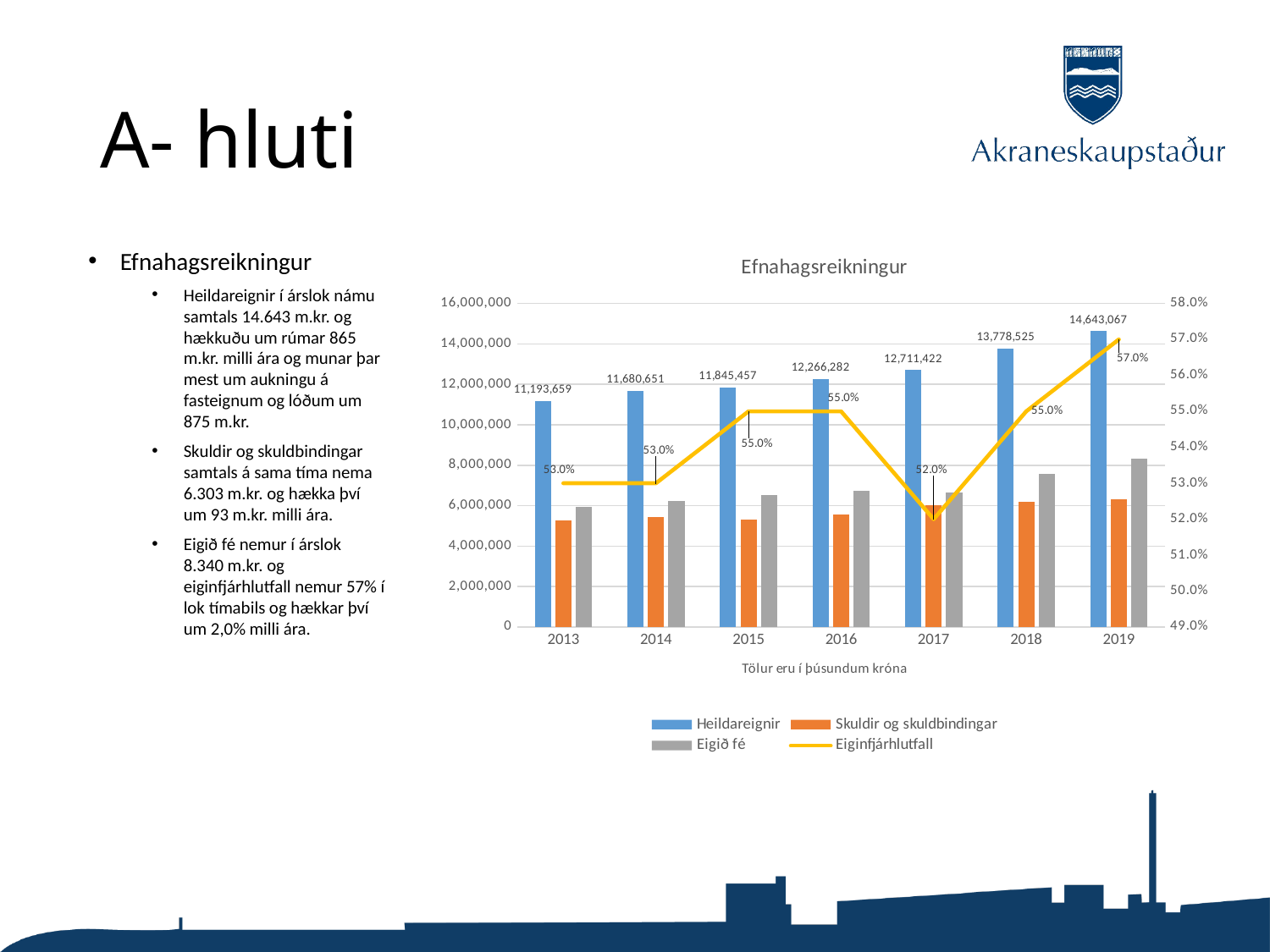
What is the value of Heildareignir for 2019? 14,643,067 Is the value for Skuldir og skuldbindingar in 2019 greater or less than 8,000,000? less Which is larger, Heildareignir in 2016 or in 2017? 2017 How many years are shown on the x axis? 7 Does Heildareignir rise or fall from 2013 to 2019? rise Which year has the highest Heildareignir? 2019 Which year has the lowest Eiginfjárhlutfall? 2017 How many series does the legend list? 4 What is the Eiginfjárhlutfall for 2017? 52.0% What is the difference in Heildareignir between 2019 and 2018? 864,542 What is the value of Heildareignir for 2013? 11,193,659 What is the Eiginfjárhlutfall for 2019? 57.0%